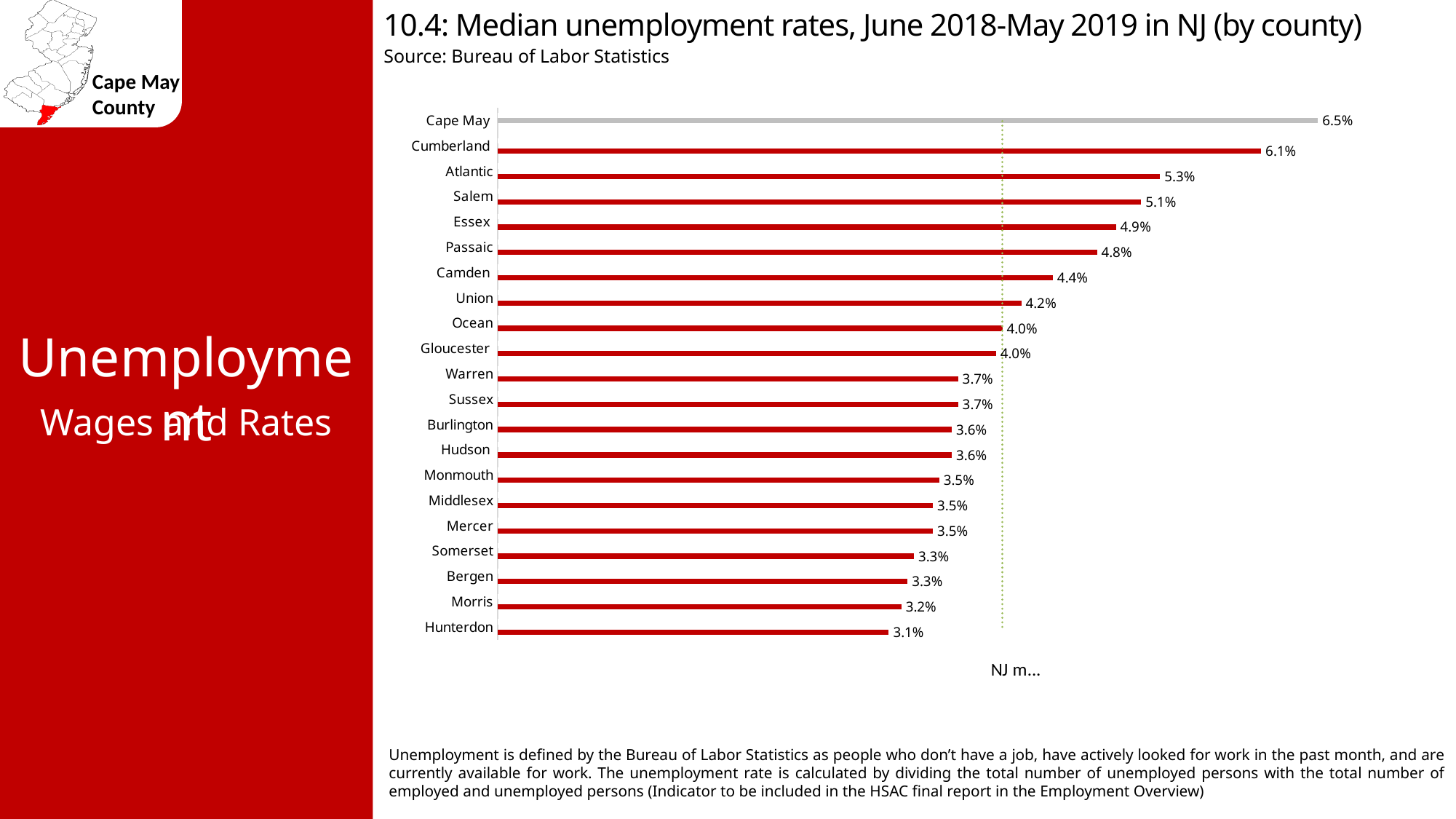
Which county has the highest median unemployment rate? Cape May What is the source of the data cited under the chart title? Bureau of Labor Statistics What is the median unemployment rate for Cape May? 6.5% What is the median unemployment rate for Camden? 4.4% What is the median unemployment rate for Hunterdon? 3.1% Which county has a higher median unemployment rate, Essex or Union? Essex Which county has the lowest median unemployment rate? Hunterdon What kind of chart is used to show the median unemployment rates? Bar chart How many counties are shown in the chart? 21 What is the median unemployment rate for Cumberland? 6.1% What is the difference between the median unemployment rates of Atlantic and Salem? 0.2% What is the difference between the median unemployment rates of Cape May and Hunterdon? 3.4%